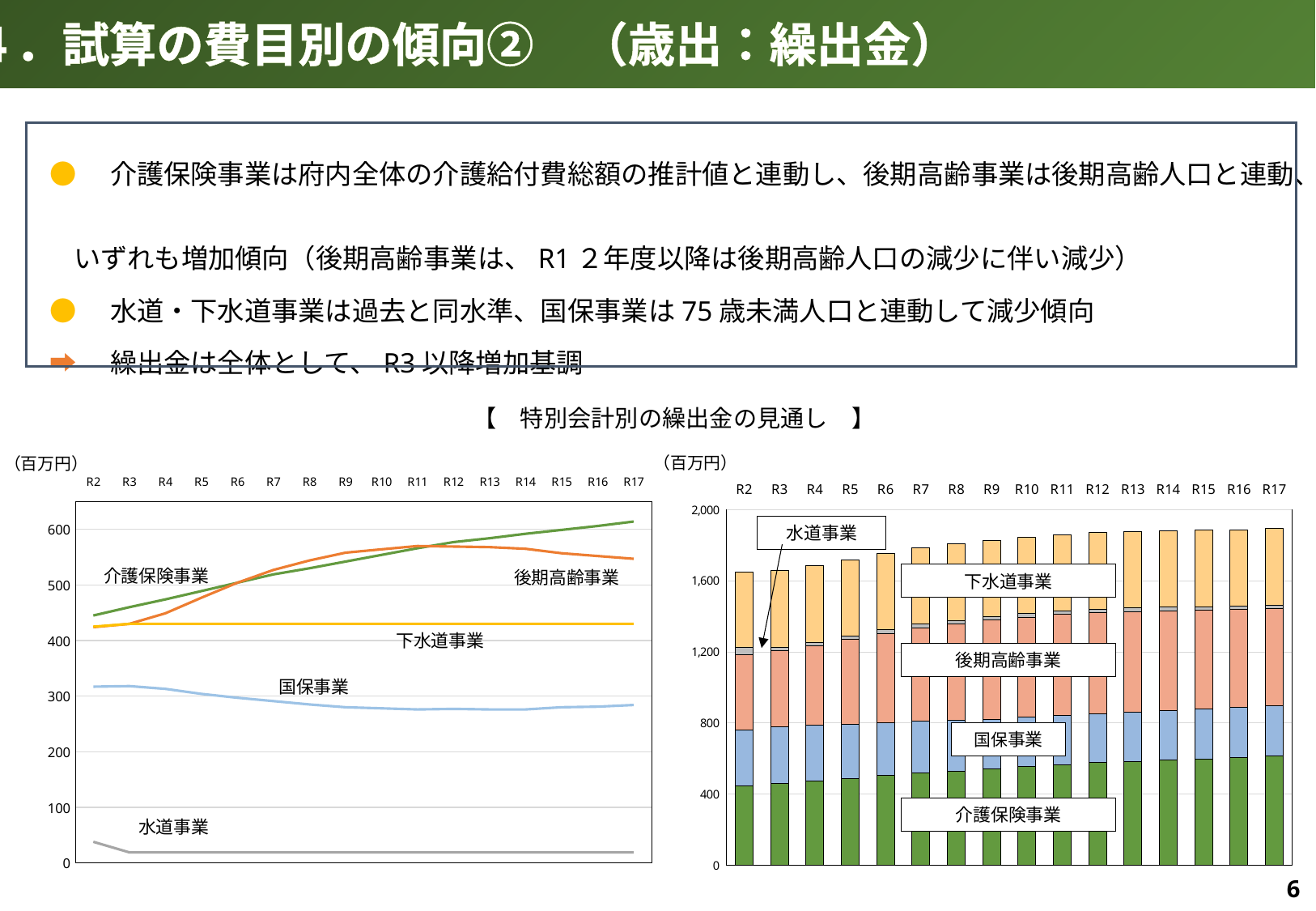
In the left chart, is the value for 介護保険事業 at R2 greater or less than 500? less In the left chart, how many series (lines) are plotted? 5 In the left chart, how many fiscal years are shown along the x axis? 16 In the left chart, which series has the lowest values across all years? 水道事業 What kind of chart is the right chart on the slide? bar chart In the left chart, is the value for 水道事業 at R17 greater or less than 100? less In the left chart, at R17, which is larger: 後期高齢事業 or 介護保険事業? 介護保険事業 In the left chart, is the value for 国保事業 at R2 greater or less than 300? greater What kind of chart is the left chart on the slide? line chart In the right chart, how many stacked bars are there? 16 In the left chart, does the 国保事業 line rise or fall from R2 to R17? fall